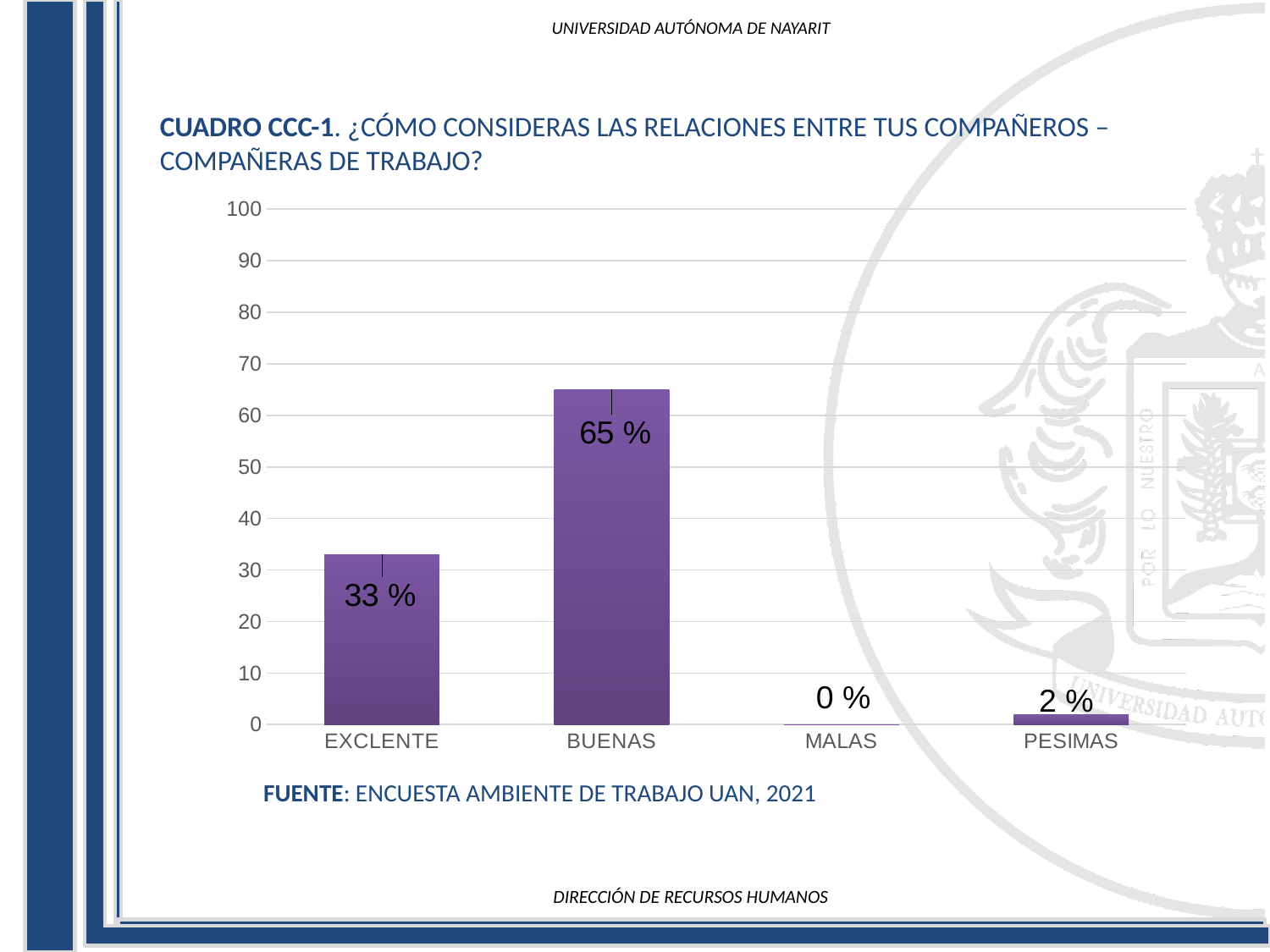
Which is larger, the value for EXCLENTE or the value for PESIMAS? EXCLENTE How many categories are shown on the x axis? 4 What is the value for MALAS? 0 % Is the value for BUENAS greater or less than 50? greater What source is cited below the chart? ENCUESTA AMBIENTE DE TRABAJO UAN, 2021 What is the value for PESIMAS? 2 % What kind of chart is shown on the slide? bar chart What is the difference between the values for BUENAS and EXCLENTE? 32 % What is the value for EXCLENTE? 33 % What is the value for BUENAS? 65 % Which category has the highest value? BUENAS Which category has the lowest value? MALAS